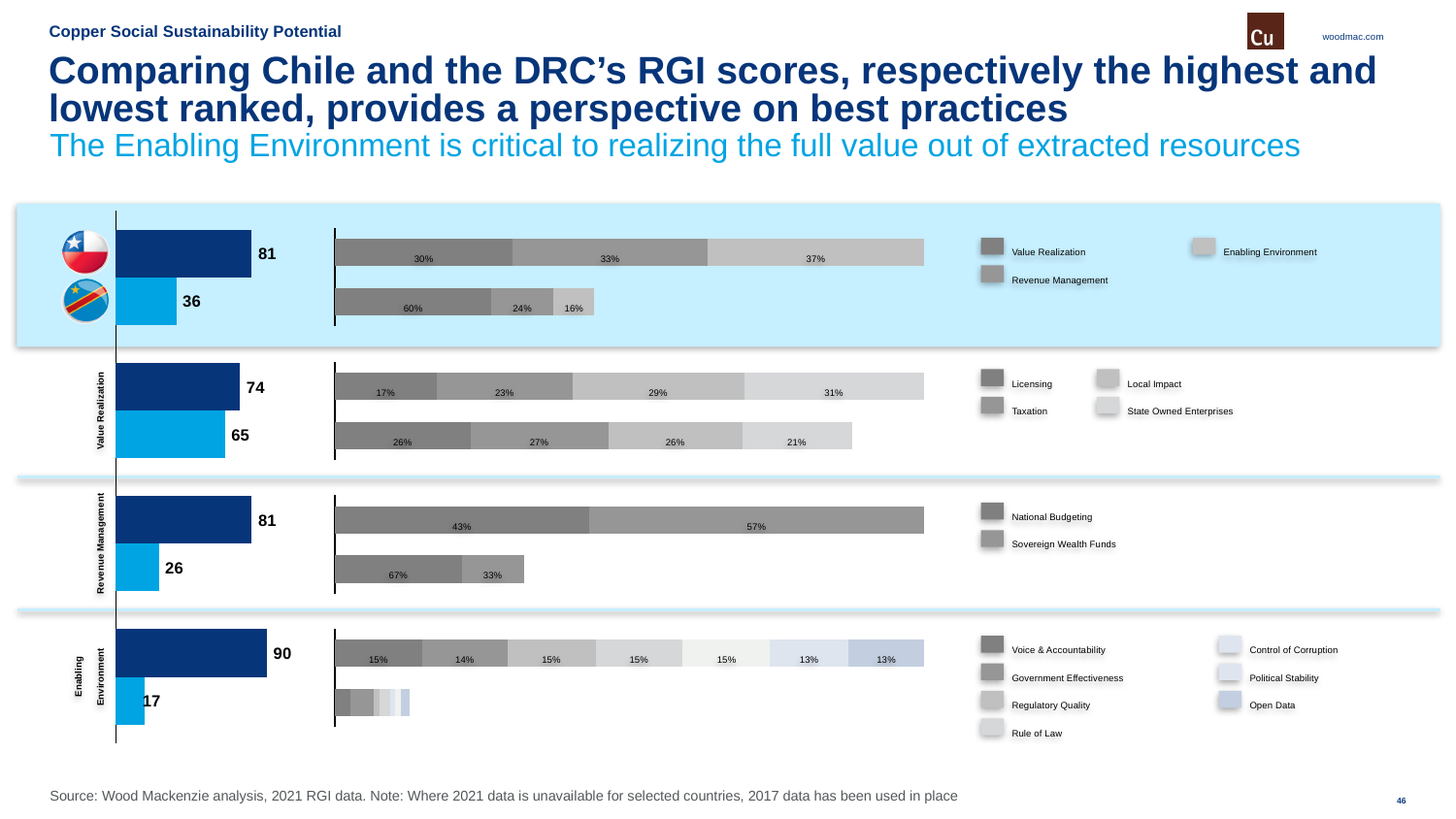
In the top-row stacked bar for the DRC, what share is attributed to Value Realization? 60% In the Value Realization row, what is the DRC's score? 65 Across the three component rows (Value Realization, Revenue Management, Enabling Environment), which component has the lowest DRC score? Enabling Environment In the top-row stacked bar for Chile, what share is attributed to Enabling Environment? 37% Across the three component rows, which component has the highest Chile score? Enabling Environment What is Chile's overall RGI score shown in the top row of the slide? 81 In the Revenue Management row, what is Chile's score? 81 In the Revenue Management row, what is the difference between Chile's score and the DRC's score? 55 In the Enabling Environment row, what is the difference between Chile's score and the DRC's score? 73 In the Revenue Management stacked bar for Chile, what share is attributed to Sovereign Wealth Funds? 57% What is the DRC's overall RGI score shown in the top row of the slide? 36 How many entries does the legend for the Enabling Environment row list? 7